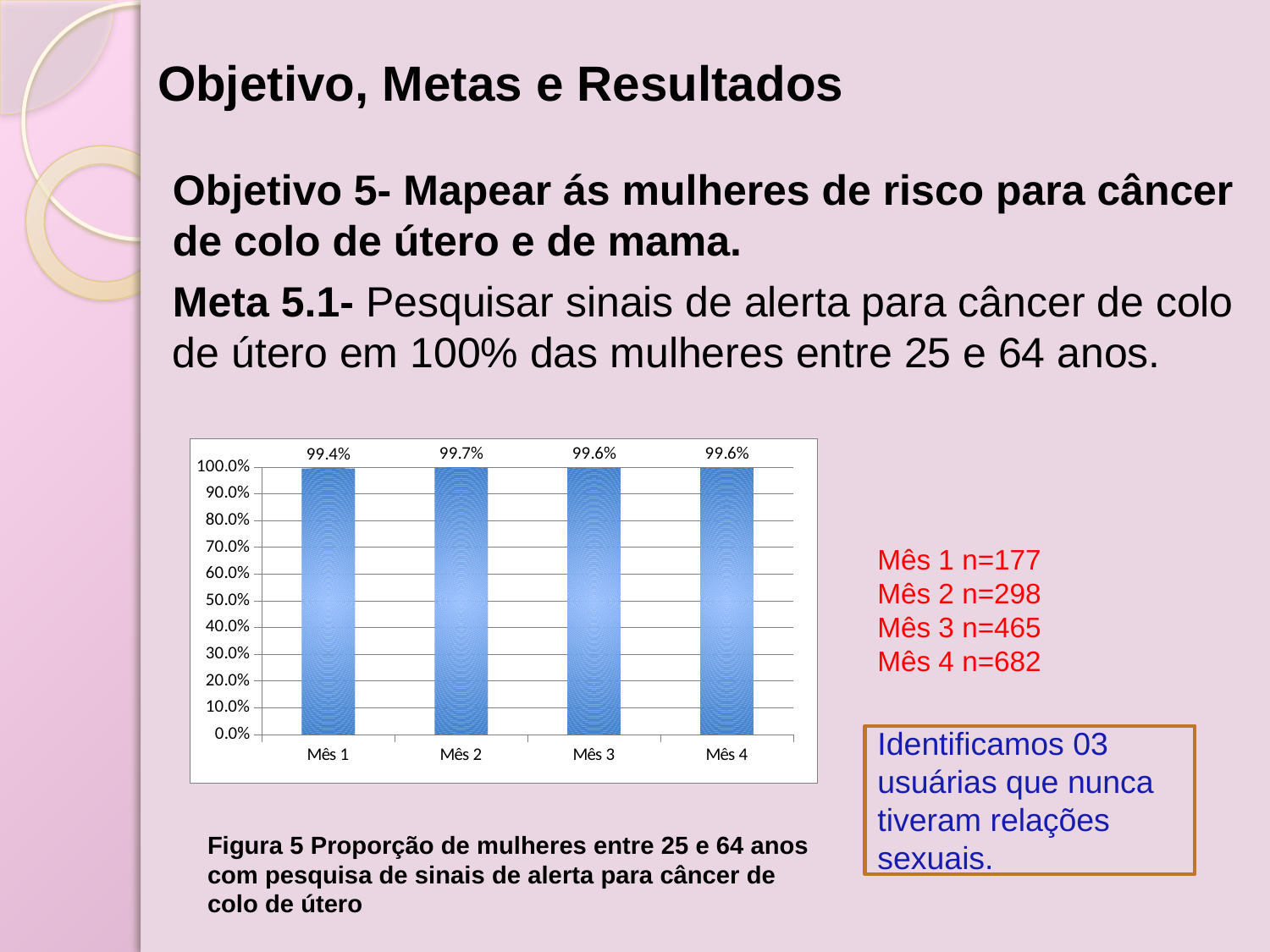
How many months are shown on the x axis? 4 What is the difference between the values for Mês 2 and Mês 1? 0.3% What is the value for Mês 2? 99.7% What is the value for Mês 1? 99.4% What is the value for Mês 3? 99.6% Which month has the highest value? Mês 2 What kind of chart is shown on the slide? bar chart Is the value for Mês 4 greater or less than 90.0%? greater Which is larger, the value for Mês 2 or the value for Mês 3? Mês 2 What is the value for Mês 4? 99.6% Which month has the lowest value? Mês 1 What is the highest tick value shown on the y axis? 100.0%